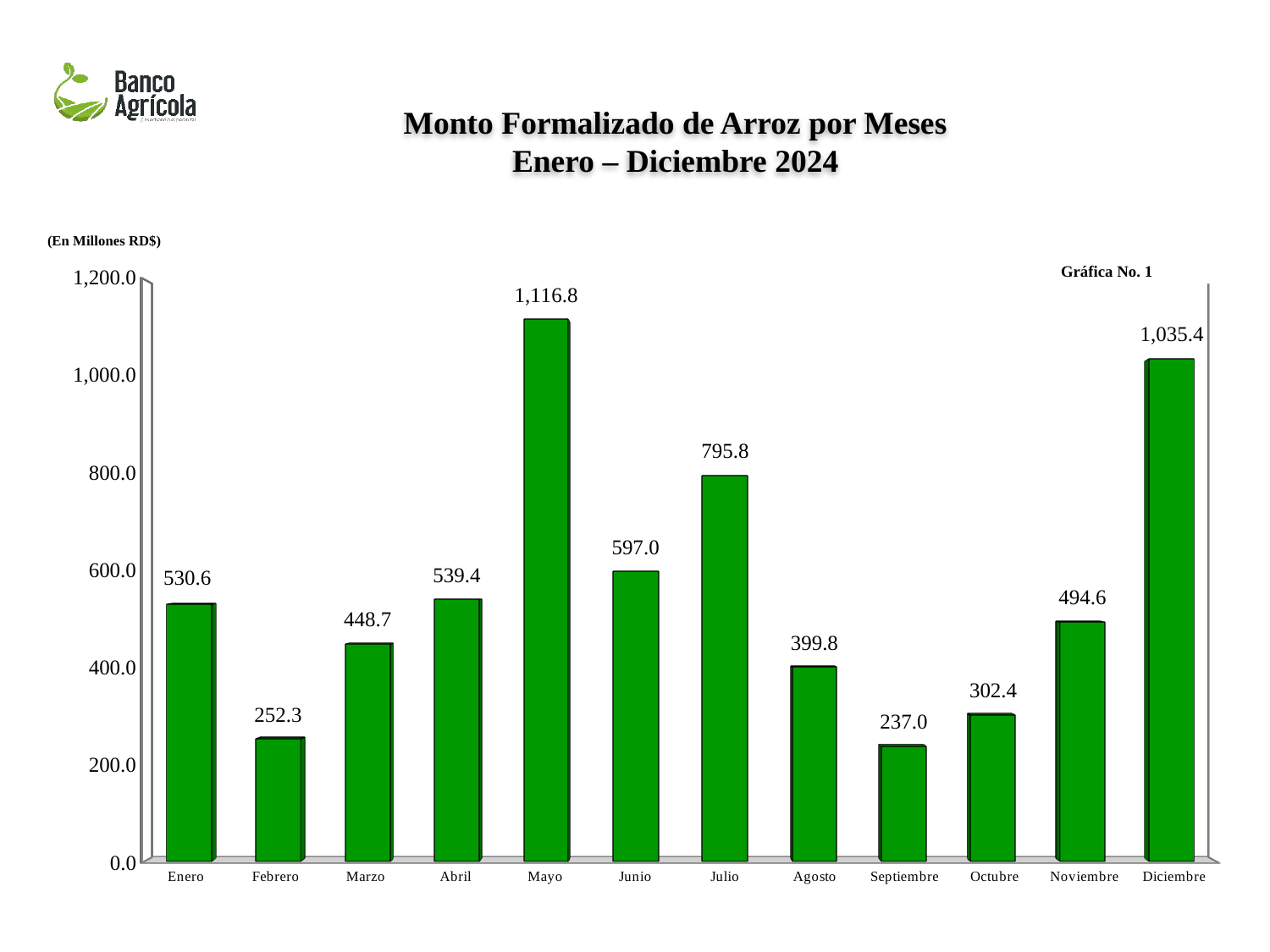
What unit is stated for the values in the chart? En Millones RD$ What is the difference between the values for Mayo and Diciembre? 81.4 Which month has the lowest value? Septiembre What kind of chart is shown on the slide? bar chart Is the value for Agosto greater or less than 400.0? less Which is larger, the value for Enero or the value for Abril? Abril What is the value for Diciembre? 1,035.4 What is the value for Septiembre? 237.0 What is the value for Mayo? 1,116.8 What is the difference between the values for Julio and Junio? 198.8 How many months are shown on the x axis? 12 Which month has the highest value? Mayo